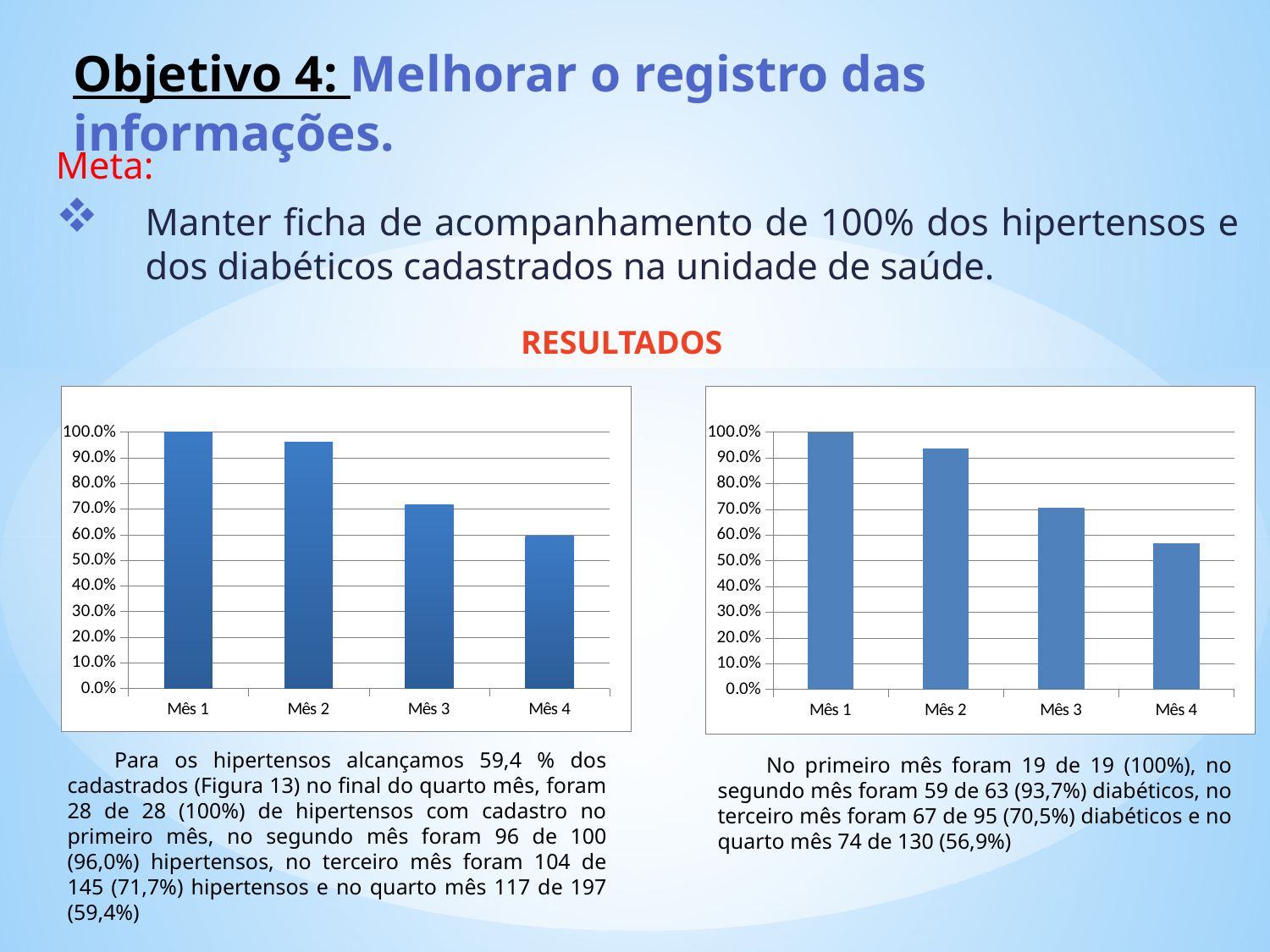
In the right chart, is the value for Mês 4 greater or less than 60.0%? less In the left chart, is the value for Mês 3 greater or less than 70.0%? greater What is the heading printed above the two charts? RESULTADOS In the right chart, which month has the highest value? Mês 1 In the right chart, is the value for Mês 2 greater or less than 90.0%? greater In the left chart, do the values rise or fall from Mês 1 to Mês 4? fall In the left chart, which is larger, the value for Mês 2 or the value for Mês 3? Mês 2 What kind of chart is the left chart on the slide? bar chart In the right chart, what is the value for Mês 1? 100.0% In the left chart, which month has the lowest value? Mês 4 In the left chart, what is the value for Mês 1? 100.0% How many months are shown on the x axis of the right chart? 4